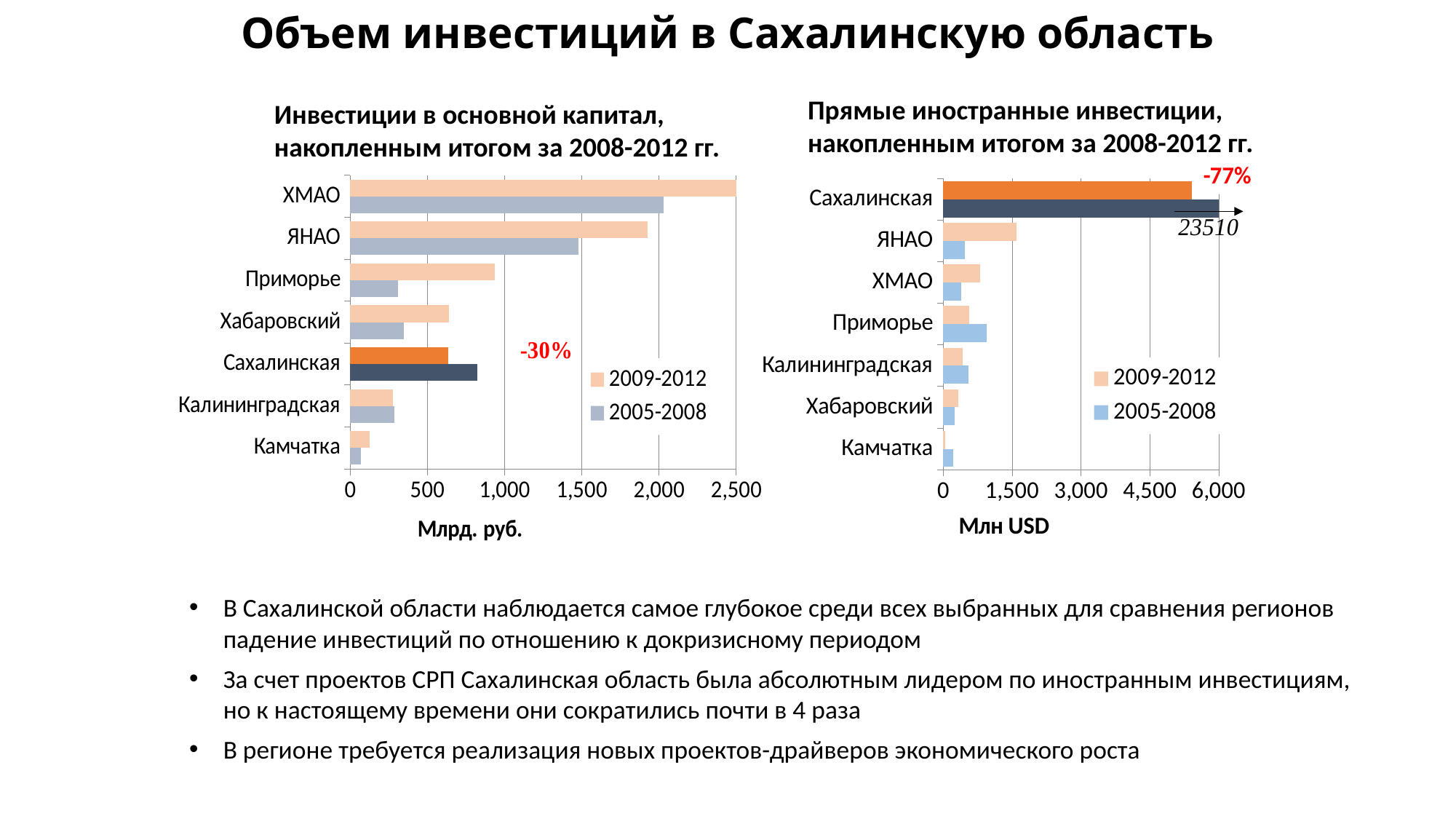
On the left chart, 'Инвестиции в основной капитал', which region has the lowest 2005-2008 value? Камчатка What unit is shown on the x axis of the left chart, 'Инвестиции в основной капитал'? Млрд. руб. What kind of chart is the left chart, 'Инвестиции в основной капитал, накопленным итогом за 2008-2012 гг.'? Bar chart On the left chart, 'Инвестиции в основной капитал', which region has the highest 2009-2012 value? ХМАО On the right chart, 'Прямые иностранные инвестиции', which region has the highest 2009-2012 value? Сахалинская How many regions are listed on the left chart, 'Инвестиции в основной капитал'? 7 On the right chart, 'Прямые иностранные инвестиции', which is larger for 2009-2012: ЯНАО or ХМАО? ЯНАО What percentage change is annotated next to Сахалинская on the right chart, 'Прямые иностранные инвестиции'? -77% On the right chart, 'Прямые иностранные инвестиции', what is the 2005-2008 value for Сахалинская? 23510 On the left chart, 'Инвестиции в основной капитал', is the 2005-2008 value for Сахалинская greater or less than 500? greater On the left chart, 'Инвестиции в основной капитал', is the 2009-2012 value for ХМАО greater or less than 2,000? greater How many series does the legend of the right chart, 'Прямые иностранные инвестиции', list? 2